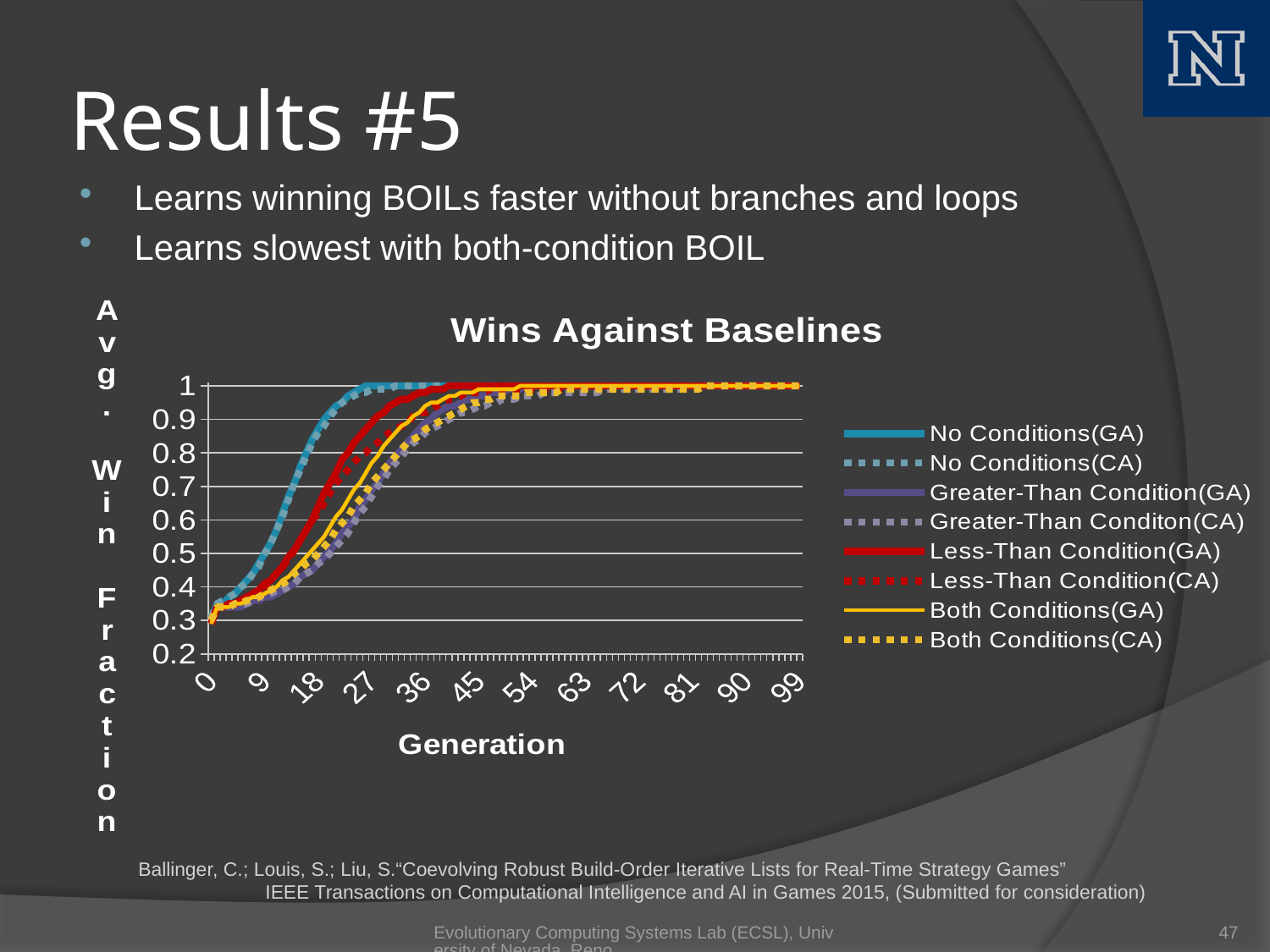
Is the value for No Conditions(GA) at generation 36 greater or less than 0.9? greater Do the values of the No Conditions(GA) series rise or fall as Generation increases? rise Which series is the first to reach a win fraction of 1 as Generation increases? No Conditions(GA) What is the title of the chart on the slide? Wins Against Baselines What is the label of the x axis of the chart? Generation What is the lowest tick value shown on the y axis of the chart? 0.2 Is the value for Both Conditions(GA) at generation 9 greater or less than 0.5? less What kind of chart is shown under the title "Wins Against Baselines"? line chart How many series does the legend of the "Wins Against Baselines" chart list? 8 How many tick labels are shown on the Generation axis? 12 Is the value for Greater-Than Condition(GA) at generation 0 greater or less than 0.5? less At generation 18, which is larger: the value for No Conditions(GA) or the value for Both Conditions(GA)? No Conditions(GA)